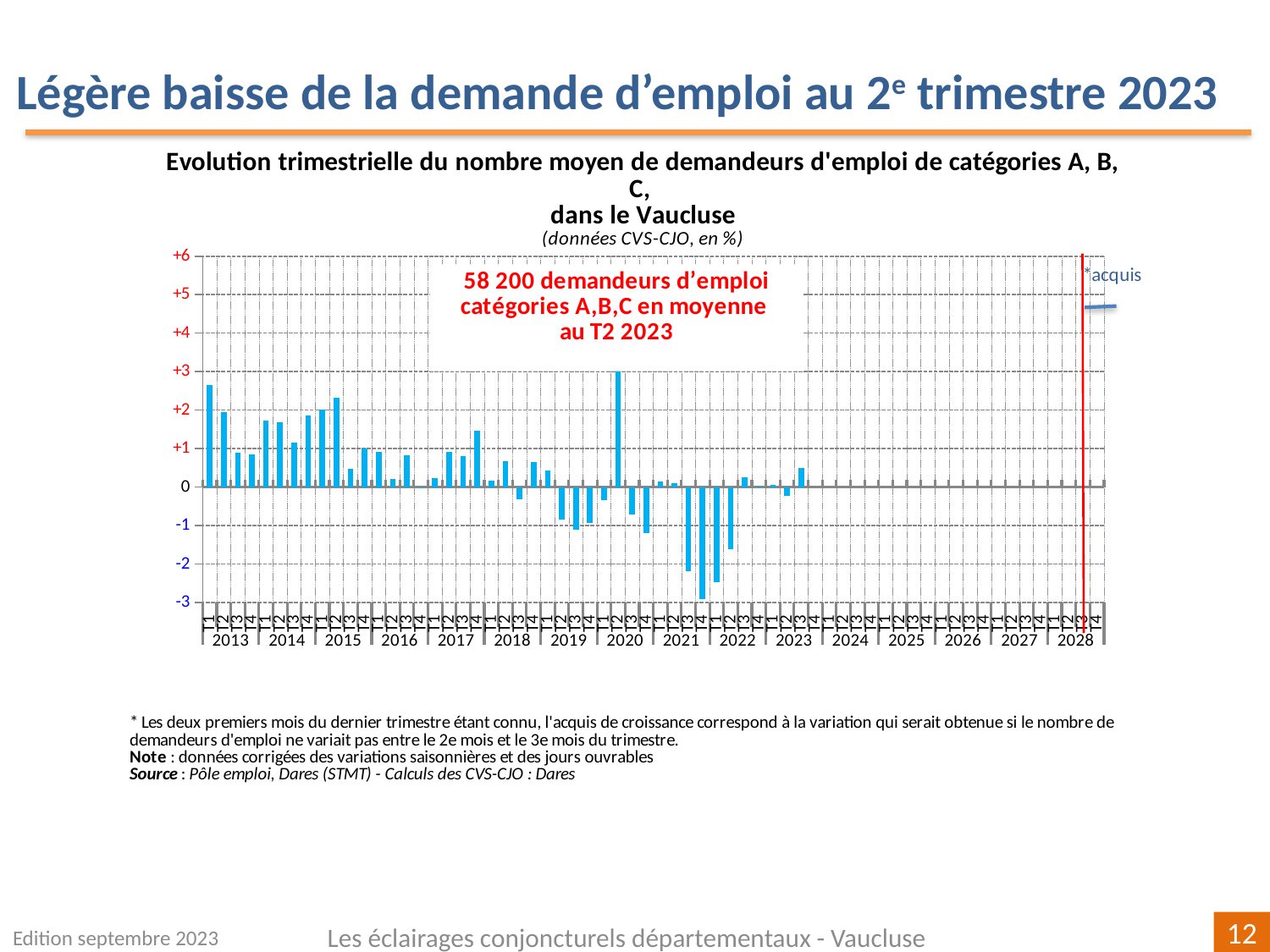
What kind of chart is shown on the slide? bar chart According to the text box on the chart, how many demandeurs d'emploi catégories A,B,C were there on average in T2 2023? 58 200 How many years are labelled along the x axis of the chart? 16 Is the value for T2 2020 greater or less than +2? greater Which quarter has the highest bar in the chart? T2 2020 Is the value for T4 2021 greater or less than -2? less Which is lower, the value for T3 2021 or the value for T4 2021? T4 2021 Which is larger, the value for T1 2013 or the value for T2 2013? T1 2013 Is the value for T1 2022 greater or less than -2? less What is the highest value shown on the chart's y axis? +6 Which quarter has the lowest bar in the chart? T4 2021